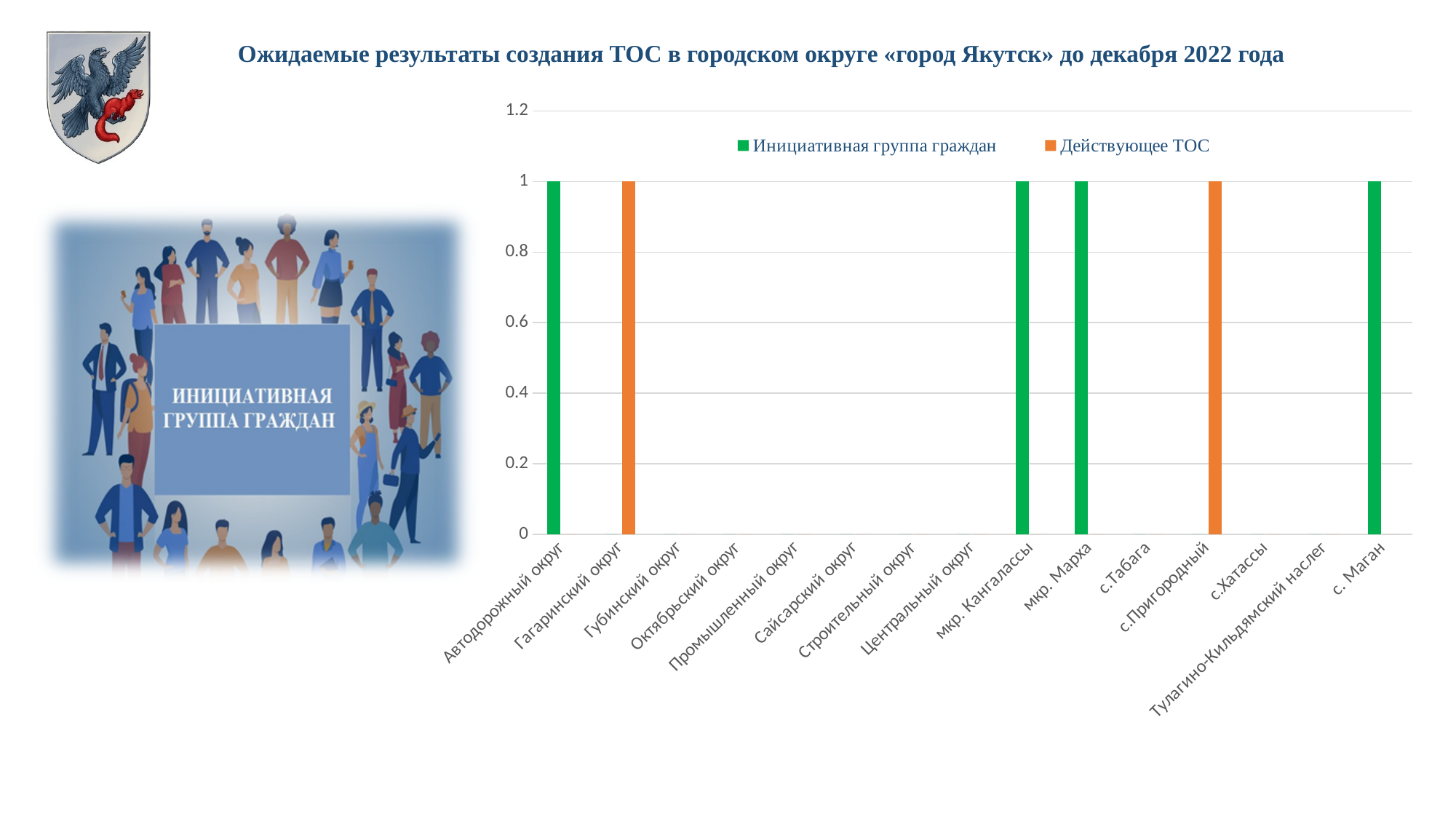
What is the title of the chart on the slide? Ожидаемые результаты создания ТОС в городском округе «город Якутск» до декабря 2022 года How many series does the chart legend list? 2 What is the value of the Инициативная группа граждан bar for с. Маган? 1 What kind of chart is shown on the slide? bar chart How many categories have an Инициативная группа граждан bar? 4 What is the value of the Инициативная группа граждан bar for Автодорожный округ? 1 Which series does the bar for мкр. Марха belong to? Инициативная группа граждан What is the value of the Действующее ТОС bar for с.Пригородный? 1 How many categories have a Действующее ТОС bar? 2 What colour represents the Действующее ТОС series in the chart? orange What is the value of the Действующее ТОС bar for Гагаринский округ? 1 How many categories are shown on the x axis of the chart? 15